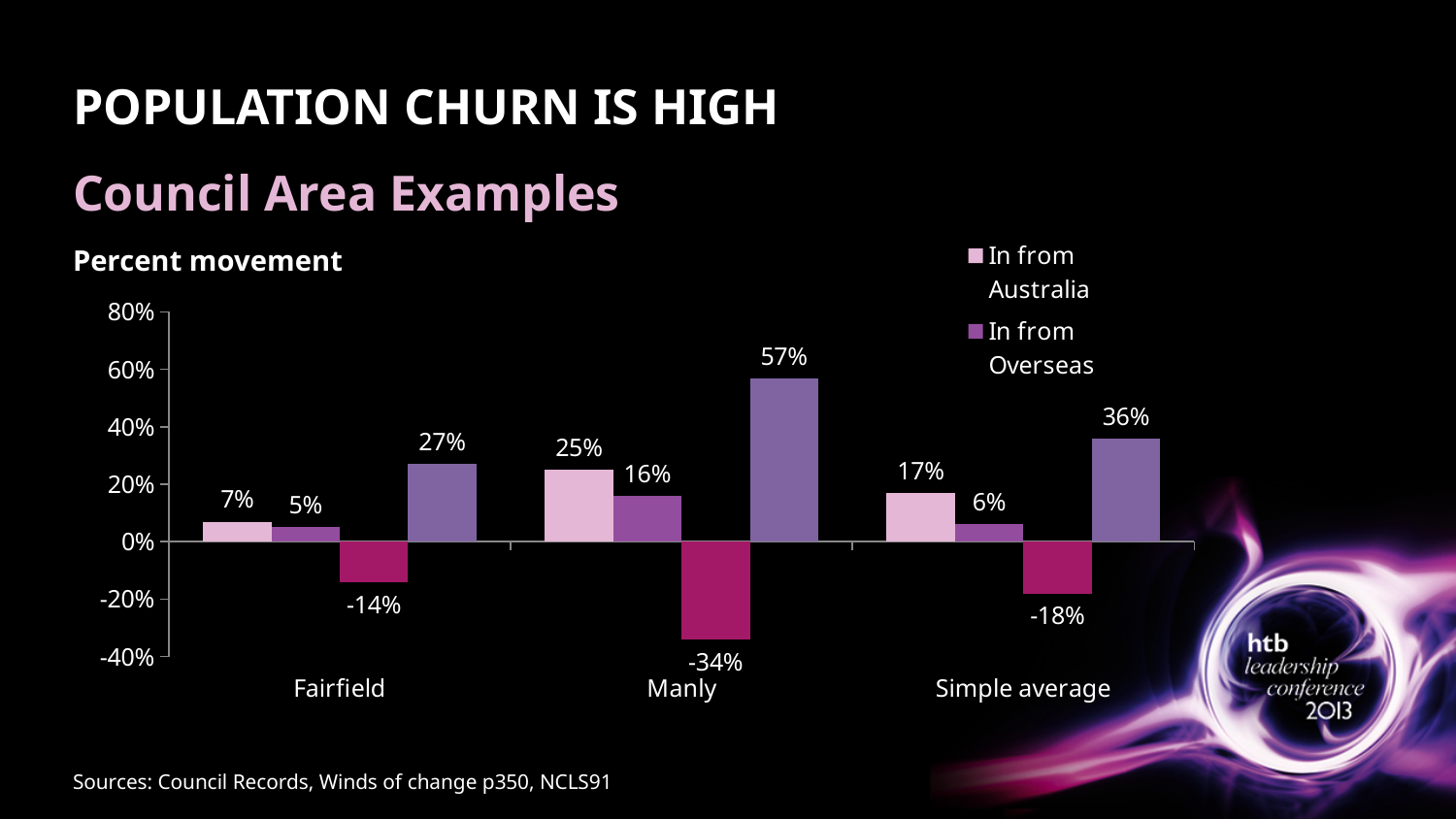
What is the difference between the In from Australia values for Manly and Fairfield? 18 percentage points What is the lowest value shown on the chart? -34% How many council area categories are shown on the x axis? 3 What is the title of the chart? Percent movement What kind of chart is shown on the slide? Bar chart What is the value for In from Overseas for Manly? 16% What is the value for In from Australia for Simple average? 17% For Manly, which is larger: In from Australia or In from Overseas? In from Australia What is the value for In from Australia for Fairfield? 7% What is the highest value shown on the chart? 57% Which council area has the highest value for In from Australia? Manly What is the value for In from Overseas for Fairfield? 5%